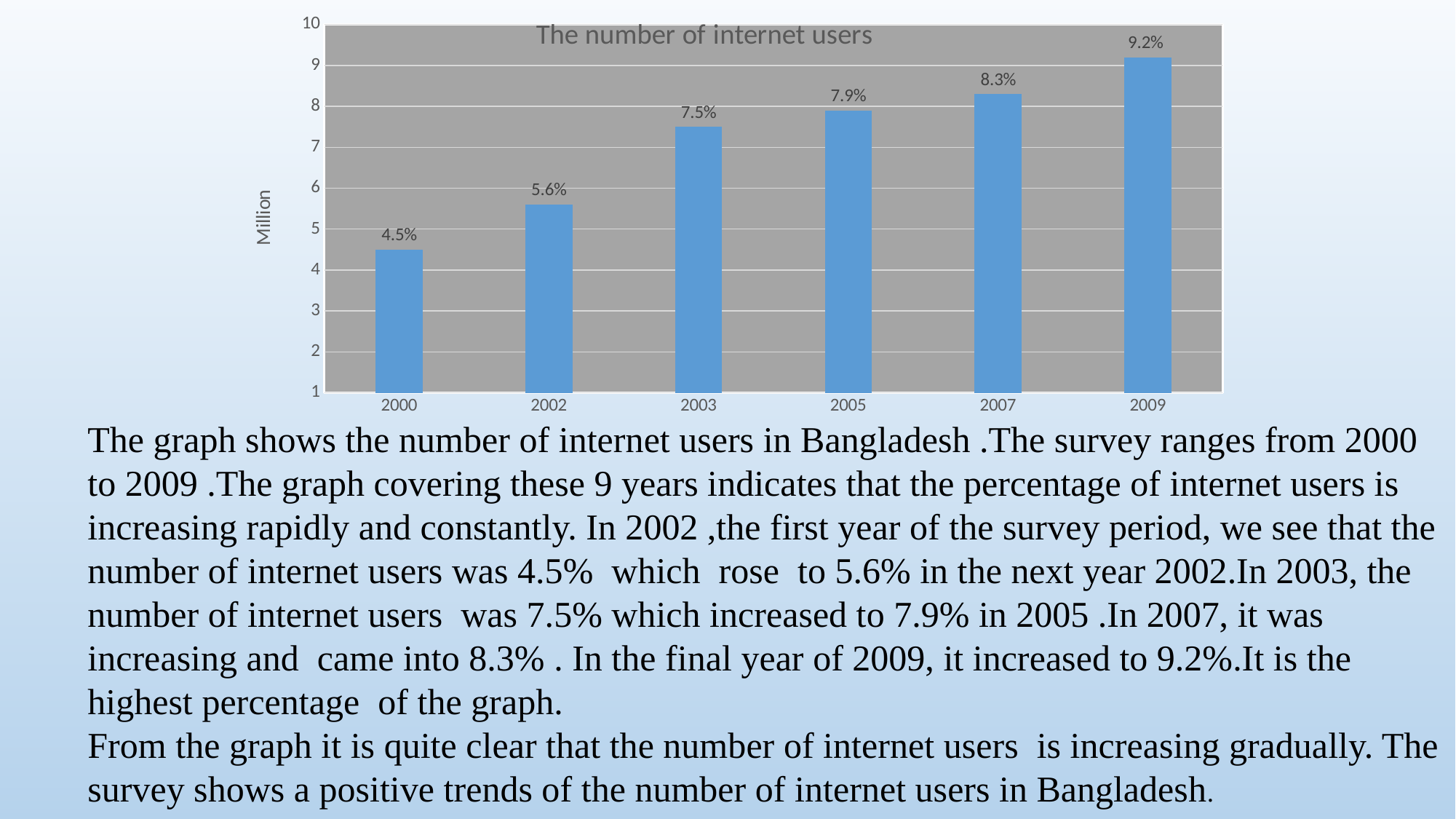
Which year has the highest value in the chart? 2009 What is the value shown for 2007 in the chart? 8.3% What is the difference between the values for 2009 and 2000? 4.7% What kind of chart is shown on the slide? Bar chart Is the value for 2009 greater or less than 9? greater Which year has the lowest value in the chart? 2000 What is the value shown for 2005 in the chart? 7.9% Which is larger, the value for 2002 or the value for 2003? 2003 How many years are shown on the x axis of the chart? 6 Do the values rise or fall from 2000 to 2009? Rise What is the value shown for 2000 in the chart? 4.5% What is the difference between the values for 2003 and 2002? 1.9%